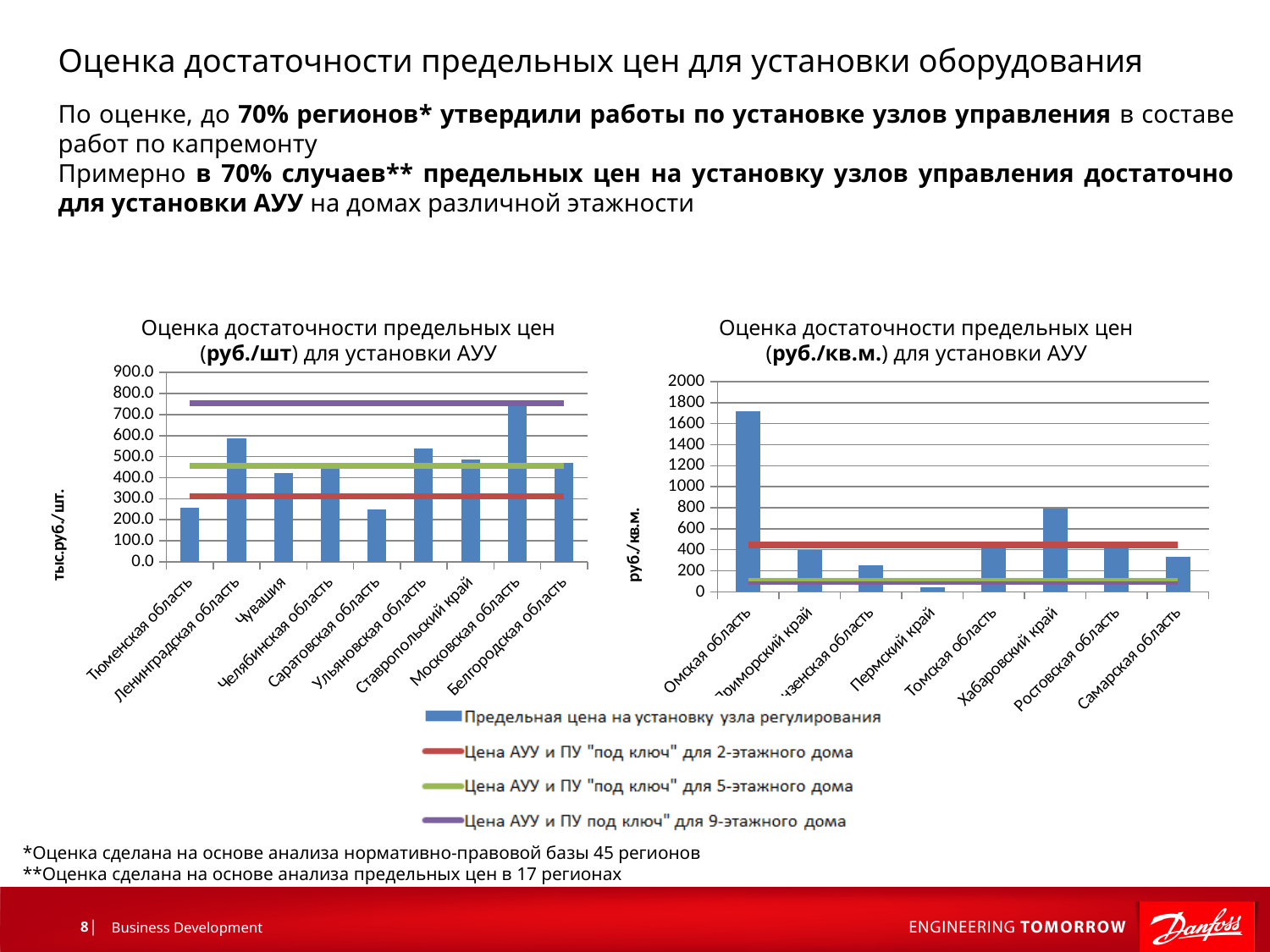
What kind of chart is the left chart titled "Оценка достаточности предельных цен (руб./шт) для установки АУУ"? combination bar and line chart How many regions are shown on the x axis of the left chart (руб./шт)? 9 In the right chart (руб./кв.м.), is the value for Омская область greater or less than 1600? greater In the right chart (руб./кв.м.), which region has the highest bar? Омская область In the left chart (руб./шт), is the value for Тюменская область greater or less than 300? less In the left chart (руб./шт), which bar is taller: Ленинградская область or Чувашия? Ленинградская область In the left chart (руб./шт), is the value for Московская область greater or less than 700? greater In the right chart (руб./кв.м.), which region has the lowest bar? Пермский край How many series does the shared legend below the charts list? 4 How many regions are shown on the x axis of the right chart (руб./кв.м.)? 8 In the left chart (руб./шт), which region has the highest bar? Московская область